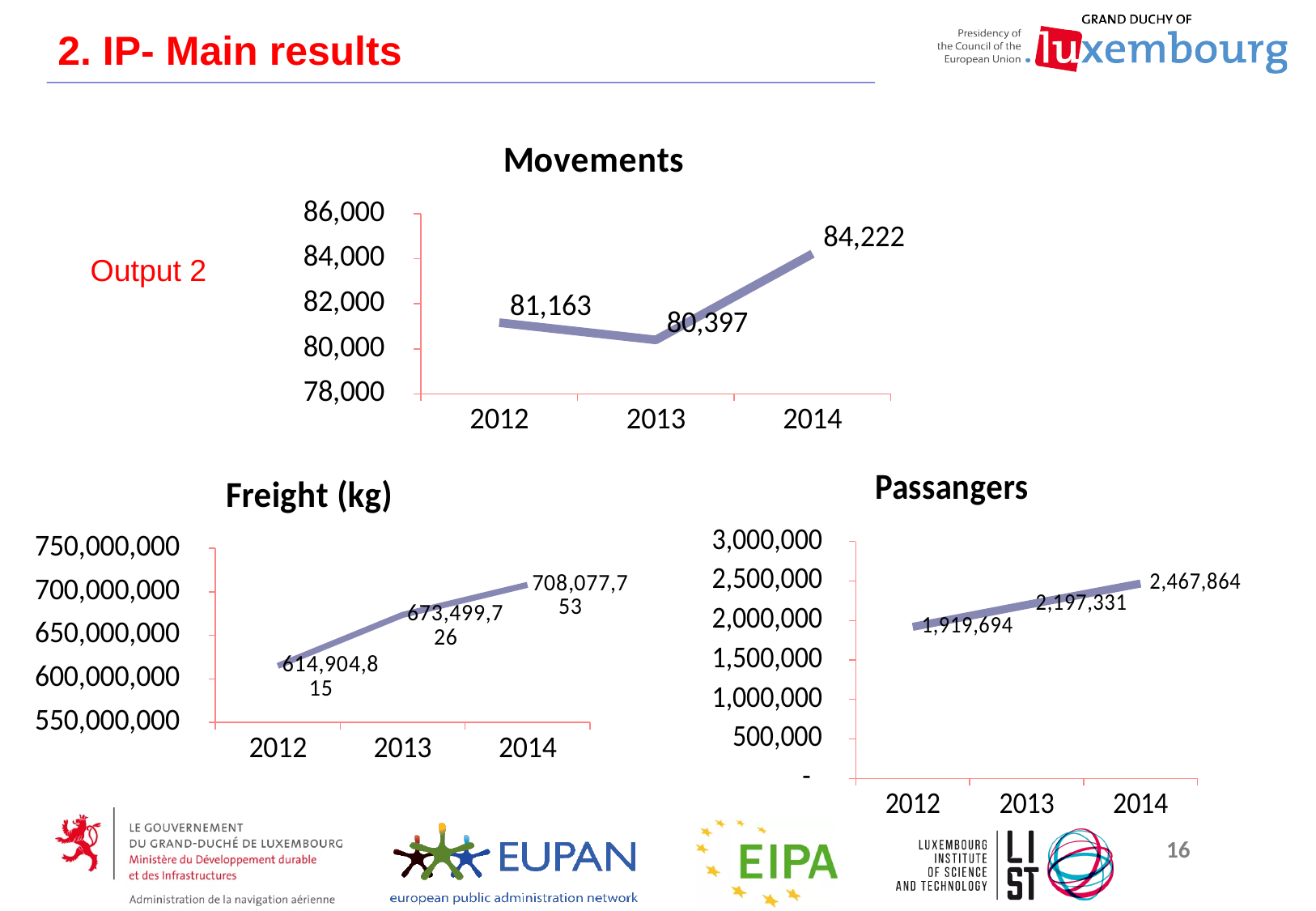
In the Passangers chart, is the value for 2013 greater or less than 2,000,000? greater In the Passangers chart, what is the value for 2012? 1,919,694 In the Freight (kg) chart, which year has the lowest value? 2012 In the Freight (kg) chart, do the values rise or fall from 2012 to 2014? rise In the Passangers chart, what is the difference between the 2014 and 2012 values? 548,170 In the Freight (kg) chart, what is the value for 2014? 708,077,753 What kind of chart is the Movements chart? line chart In the Movements chart, which year has the highest value? 2014 In the Movements chart, what is the value for 2013? 80,397 In the Movements chart, what is the difference between the 2014 and 2013 values? 3,825 How many years are plotted in the Passangers chart? 3 In the Movements chart, is the value for 2012 greater or less than 82,000? less